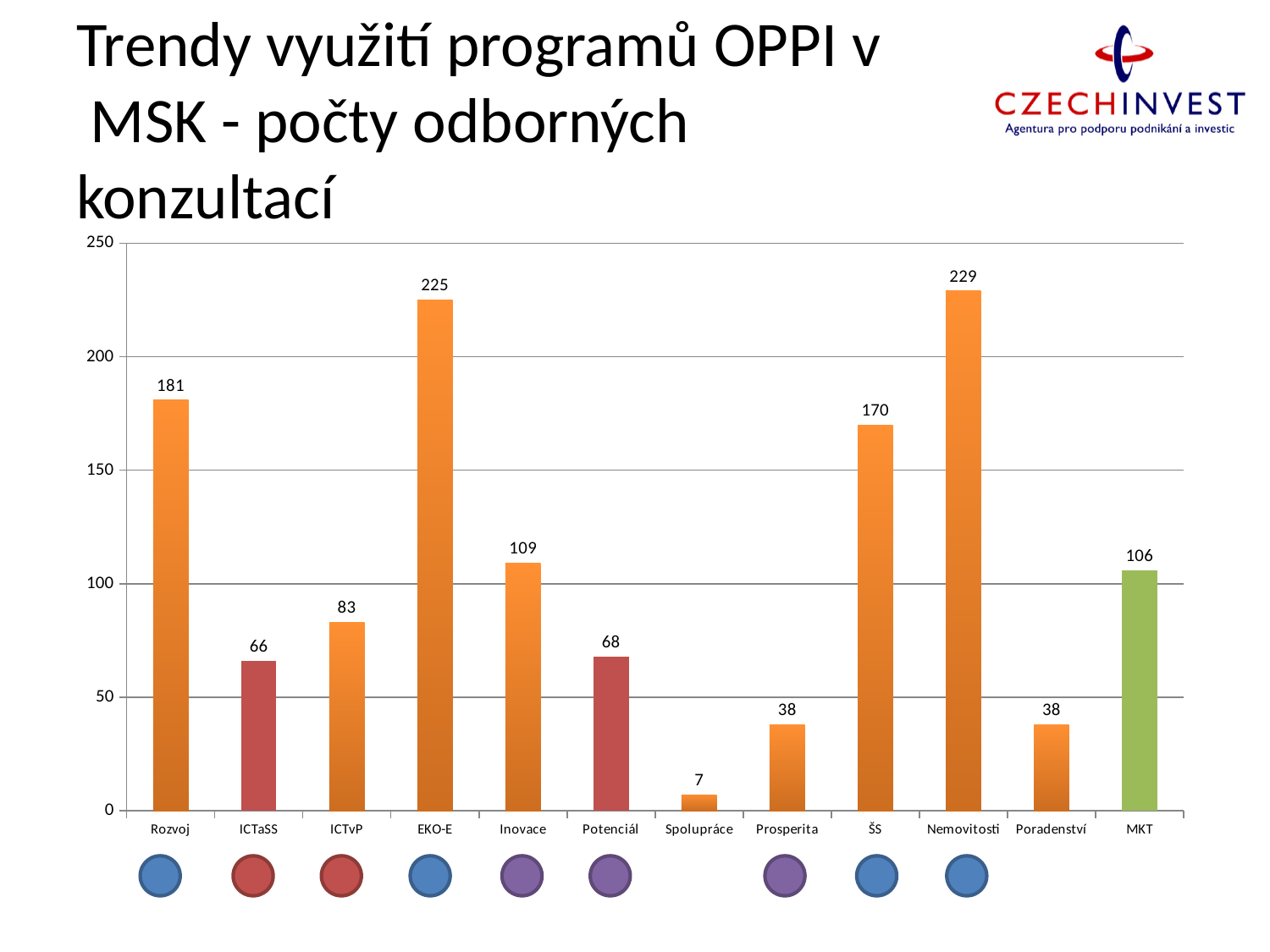
What is the value for EKO-E? 225 What is the value for Inovace? 109 Which is larger, the value for ICTvP or the value for Potenciál? ICTvP What kind of chart is shown on the slide? bar chart What is the difference between the values for Nemovitosti and EKO-E? 4 What is the value for MKT? 106 Which category has the highest value? Nemovitosti Is the value for ŠS greater or less than 150? greater What is the difference between the values for Rozvoj and ŠS? 11 What colour is the bar for MKT? green How many categories are shown on the x axis? 12 Which category has the lowest value? Spolupráce